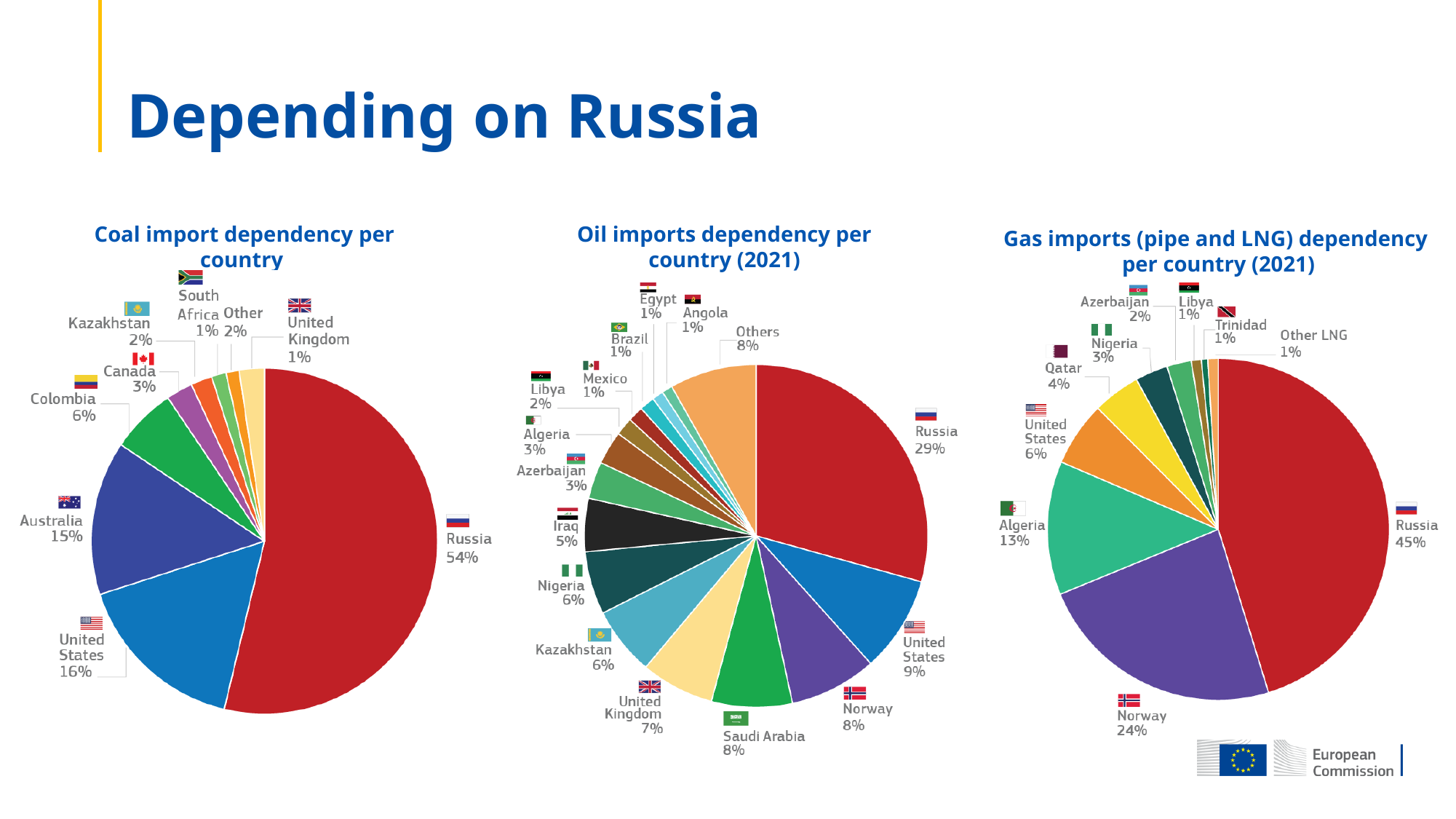
In the 'Coal import dependency per country' chart, what is the difference between the United States and Australia shares? 1% What type of chart is used for 'Oil imports dependency per country (2021)'? Pie chart In the 'Coal import dependency per country' chart, what share does Russia have? 54% In the 'Gas imports (pipe and LNG) dependency per country (2021)' chart, what is the difference between Russia's and Norway's shares? 21% How many slices does the 'Coal import dependency per country' chart have? 9 In the 'Oil imports dependency per country (2021)' chart, what is the value for Kazakhstan? 6% In the 'Oil imports dependency per country (2021)' chart, what is the value for Saudi Arabia? 8% How many charts are shown on the slide? 3 In the 'Gas imports (pipe and LNG) dependency per country (2021)' chart, what is the value for Norway? 24% In the 'Gas imports (pipe and LNG) dependency per country (2021)' chart, which country has the largest share? Russia How many slices does the 'Gas imports (pipe and LNG) dependency per country (2021)' chart have? 10 In the 'Oil imports dependency per country (2021)' chart, which is larger, the share for Iraq or the share for Nigeria? Nigeria